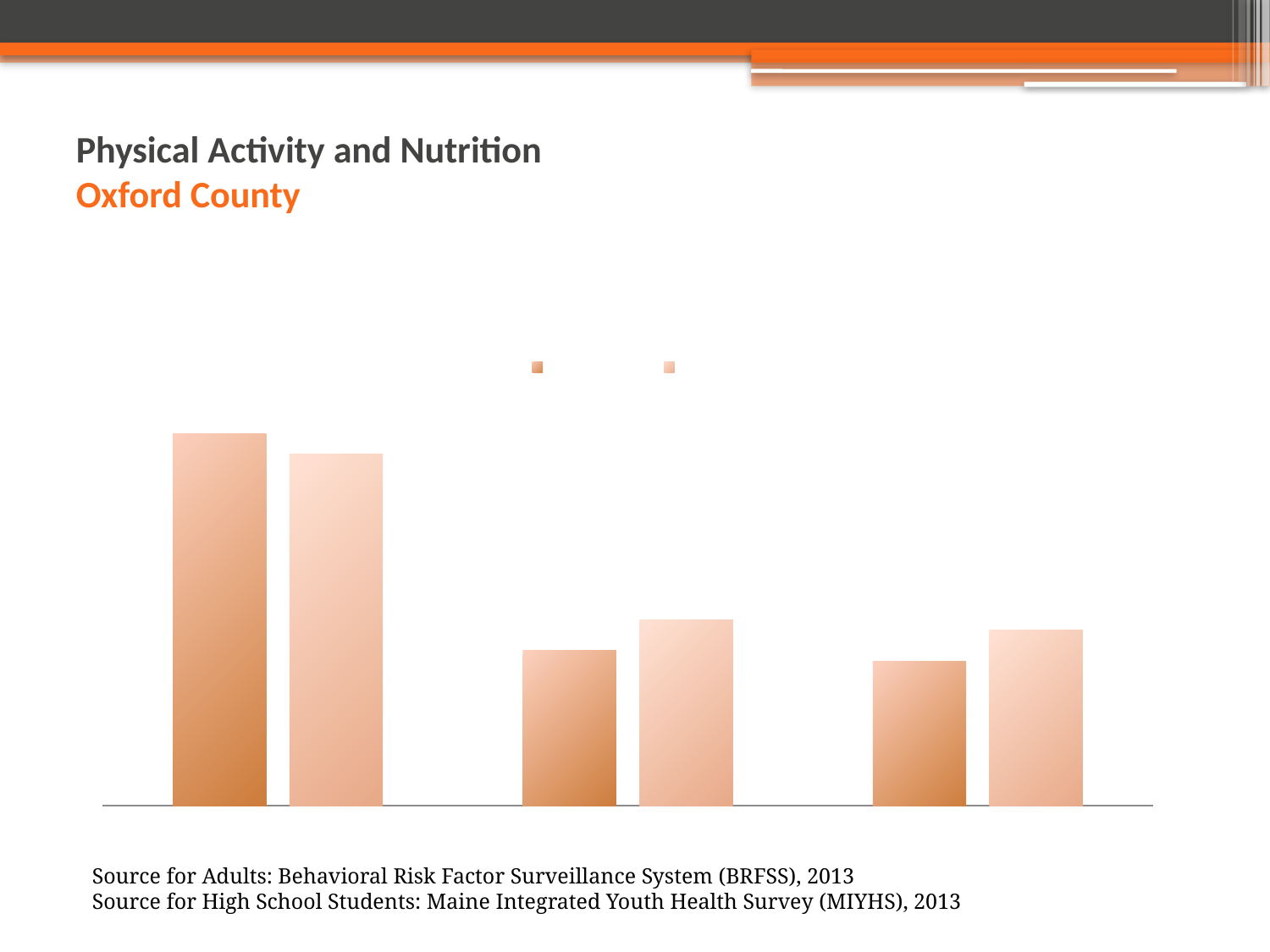
Which group of bars has the tallest bars: the leftmost, middle, or rightmost group? leftmost In the middle group, which bar is taller: the darker orange bar or the lighter orange bar? the lighter orange bar How many bars are plotted in total on the chart? 6 What kind of chart is shown on the slide? bar chart In the rightmost group, which bar is taller: the darker orange bar or the lighter orange bar? the lighter orange bar Do the darker orange bars rise or fall from left to right across the chart? fall Which group of bars has the shortest darker-orange bar: the leftmost, middle, or rightmost group? rightmost In the leftmost group, which bar is taller: the darker orange bar or the lighter orange bar? the darker orange bar Do the lighter orange bars rise or fall from left to right across the chart? fall What colour family are the bars in the chart? orange How many series does the chart's legend list? 2 How many groups of bars (categories) are plotted in the chart? 3